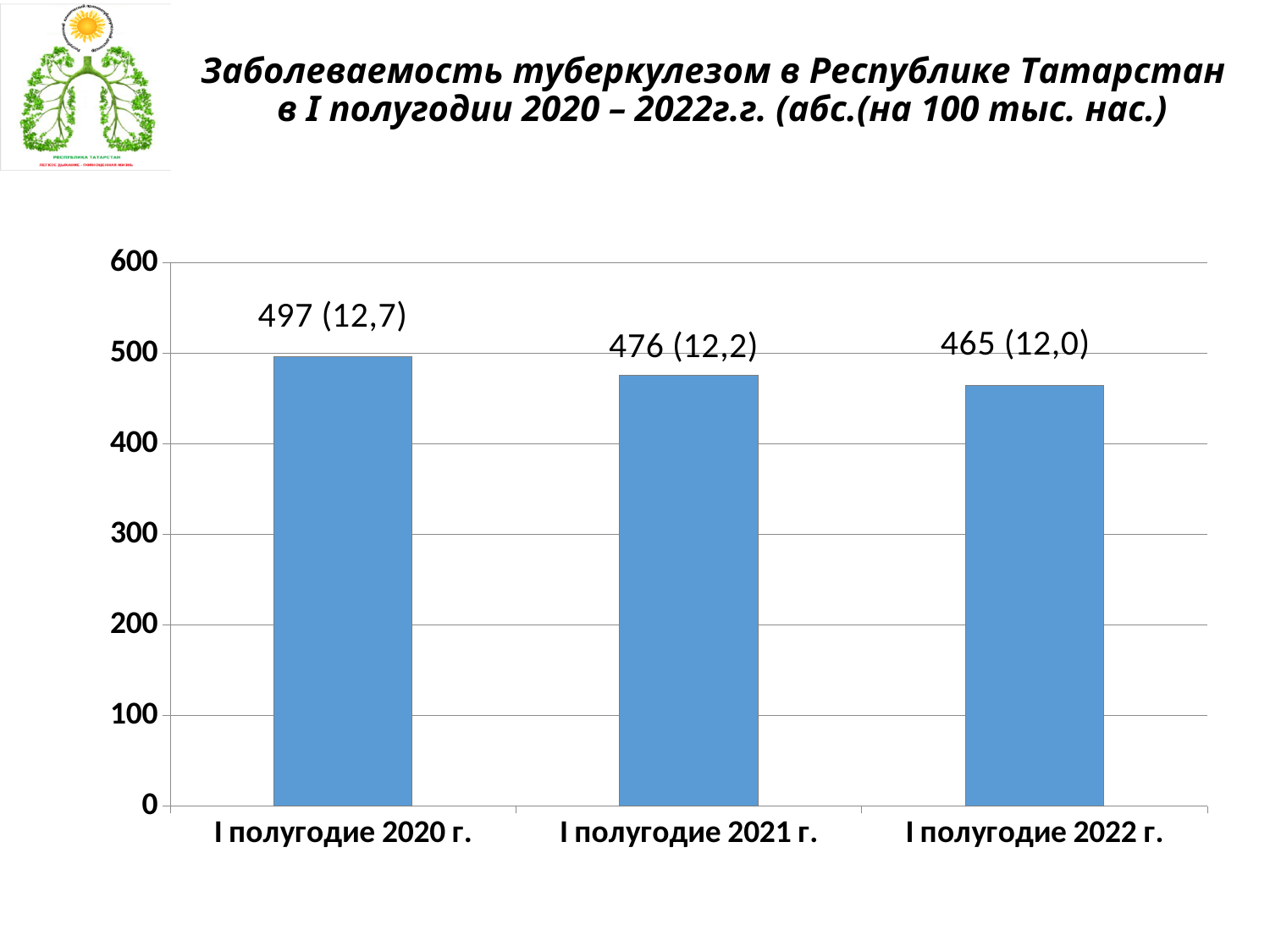
How many periods are shown on the chart? 3 What is the data label shown for I полугодие 2020 г.? 497 (12,7) What is the absolute number of cases for I полугодие 2022 г.? 465 Which is larger, the value for I полугодие 2020 г. or I полугодие 2021 г.? I полугодие 2020 г. What is the data label shown for I полугодие 2022 г.? 465 (12,0) What is the data label shown for I полугодие 2021 г.? 476 (12,2) What is the difference in absolute cases between I полугодие 2021 г. and I полугодие 2022 г.? 11 Which period has the lowest number of cases? I полугодие 2022 г. Which period has the highest number of cases? I полугодие 2020 г. What kind of chart is shown on the slide? bar chart Is the value for I полугодие 2021 г. greater or less than 500? less What is the difference in absolute cases between I полугодие 2020 г. and I полугодие 2022 г.? 32